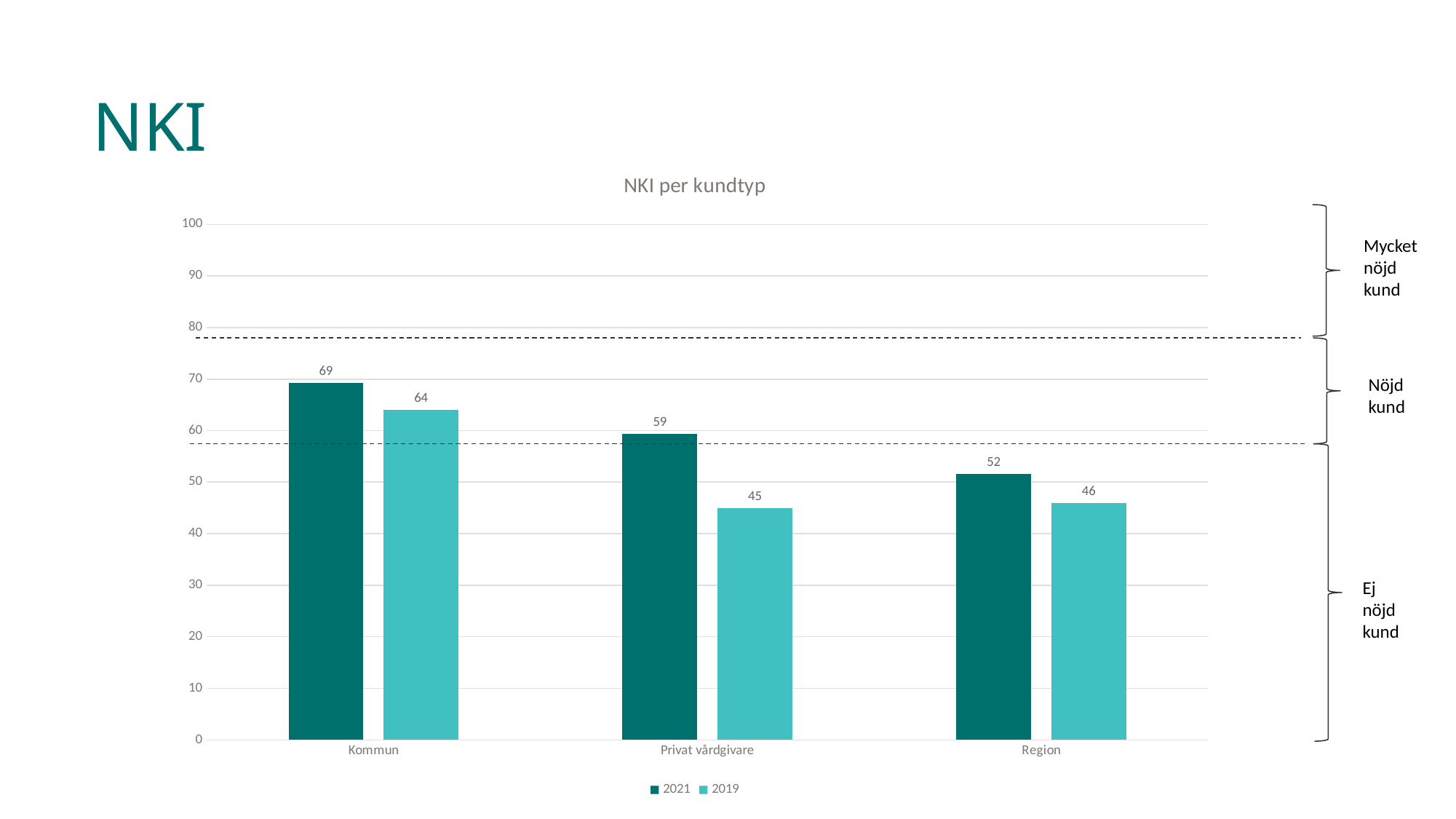
Which is larger, the 2019 value for Kommun or the 2021 value for Privat vårdgivare? 2019 value for Kommun How many series does the legend list? 2 Which customer type has the lowest NKI value in 2019? Privat vårdgivare What is the NKI value for Kommun in 2021? 69 Which customer type has the highest NKI value in 2021? Kommun What is the difference between the 2021 and 2019 NKI values for Privat vårdgivare? 14 How many customer types are shown on the x axis? 3 What is the NKI value for Region in 2021? 52 What is the NKI value for Privat vårdgivare in 2019? 45 What is the title of the chart? NKI per kundtyp What kind of chart is shown on the slide? bar chart Is the 2019 value for Region greater or less than 50? less